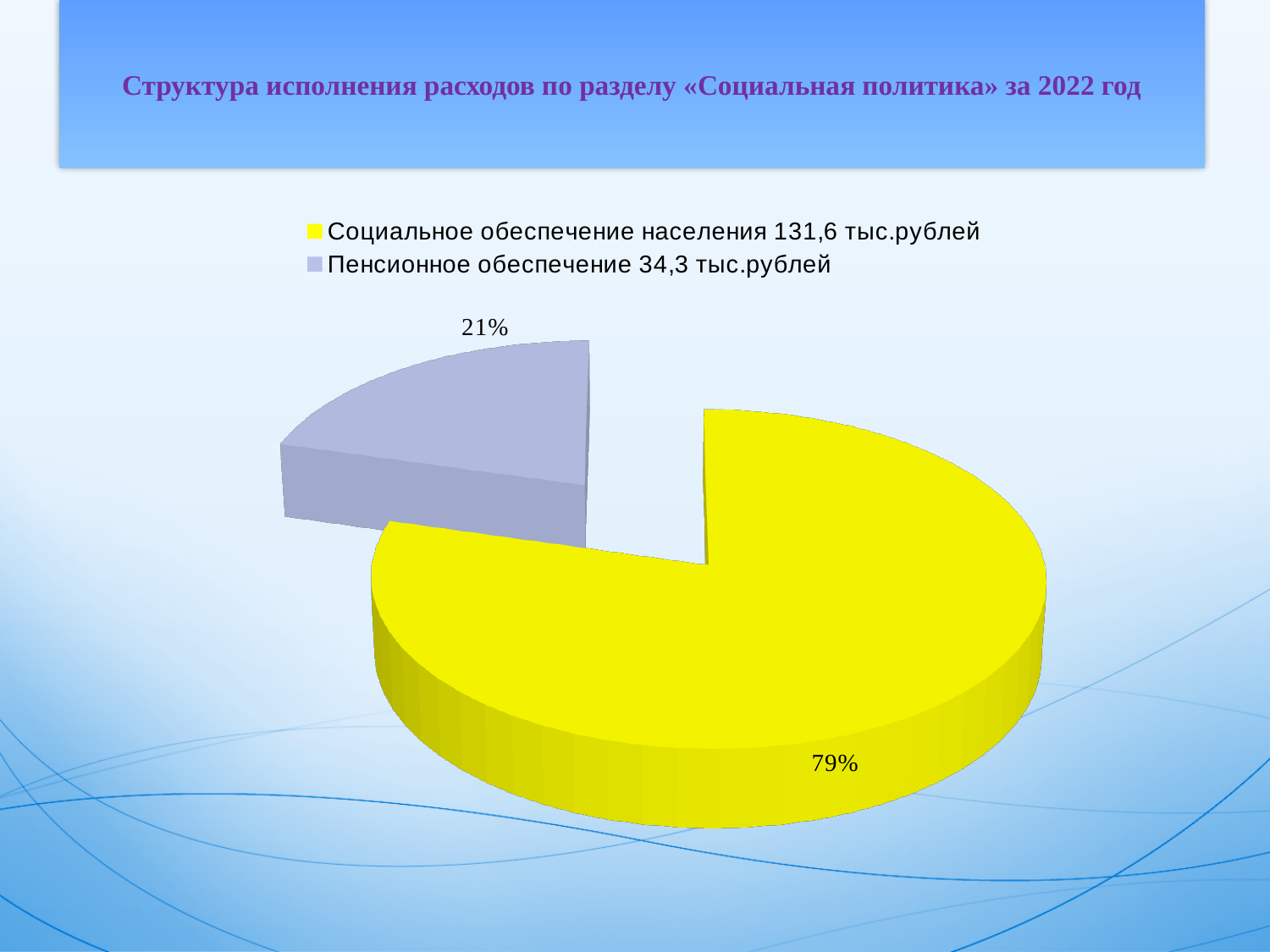
What colour is the slice for Пенсионное обеспечение? light purple (lavender) Which category has the smallest slice of the pie? Пенсионное обеспечение What amount in thousand rubles does the legend give for Социальное обеспечение населения? 131,6 тыс.рублей What amount in thousand rubles does the legend give for Пенсионное обеспечение? 34,3 тыс.рублей Which category has the largest slice of the pie? Социальное обеспечение населения What kind of chart is shown on the slide? pie chart How many slices does the pie chart have? 2 Which is larger: the slice for Социальное обеспечение населения or the slice for Пенсионное обеспечение? Социальное обеспечение населения What is the difference in percentage points between the two slices? 58 How many entries does the legend list? 2 What share of the pie does the slice for Социальное обеспечение населения represent? 79% What share of the pie does the slice for Пенсионное обеспечение represent? 21%